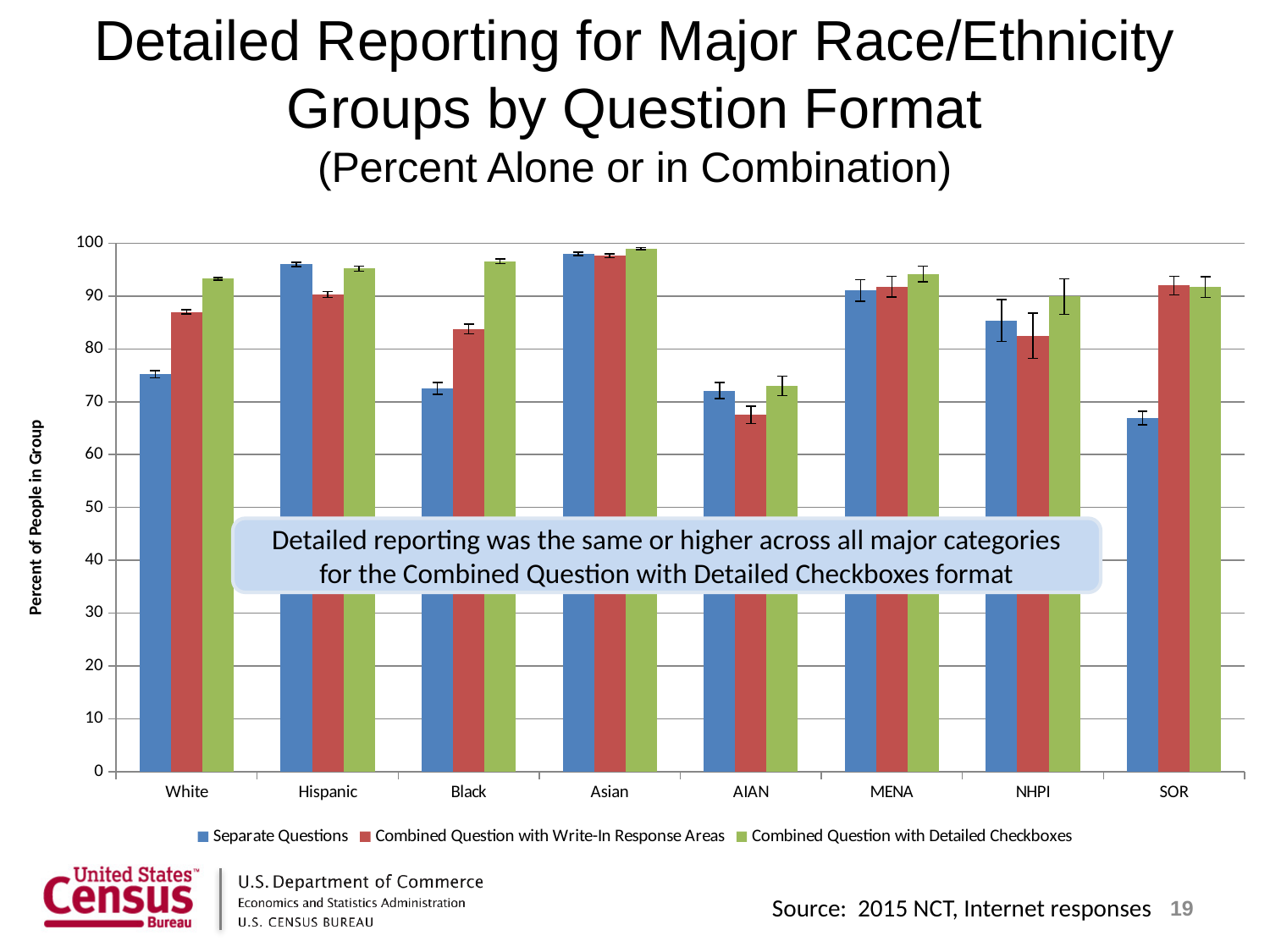
What kind of chart is shown on the slide? Bar chart For White, which is larger: Separate Questions or Combined Question with Write-In Response Areas? Combined Question with Write-In Response Areas Which group has the lowest Combined Question with Write-In Response Areas value? AIAN How many race/ethnicity groups are shown on the x axis? 8 Which group has the lowest Separate Questions value? SOR Is the Separate Questions value for Hispanic greater or less than 90? greater How many series does the legend list? 3 Is the Separate Questions value for White greater or less than 80? less Which group has the highest Combined Question with Detailed Checkboxes value? Asian Is the Combined Question with Write-In Response Areas value for AIAN greater or less than 70? less What is the title of the y axis? Percent of People in Group